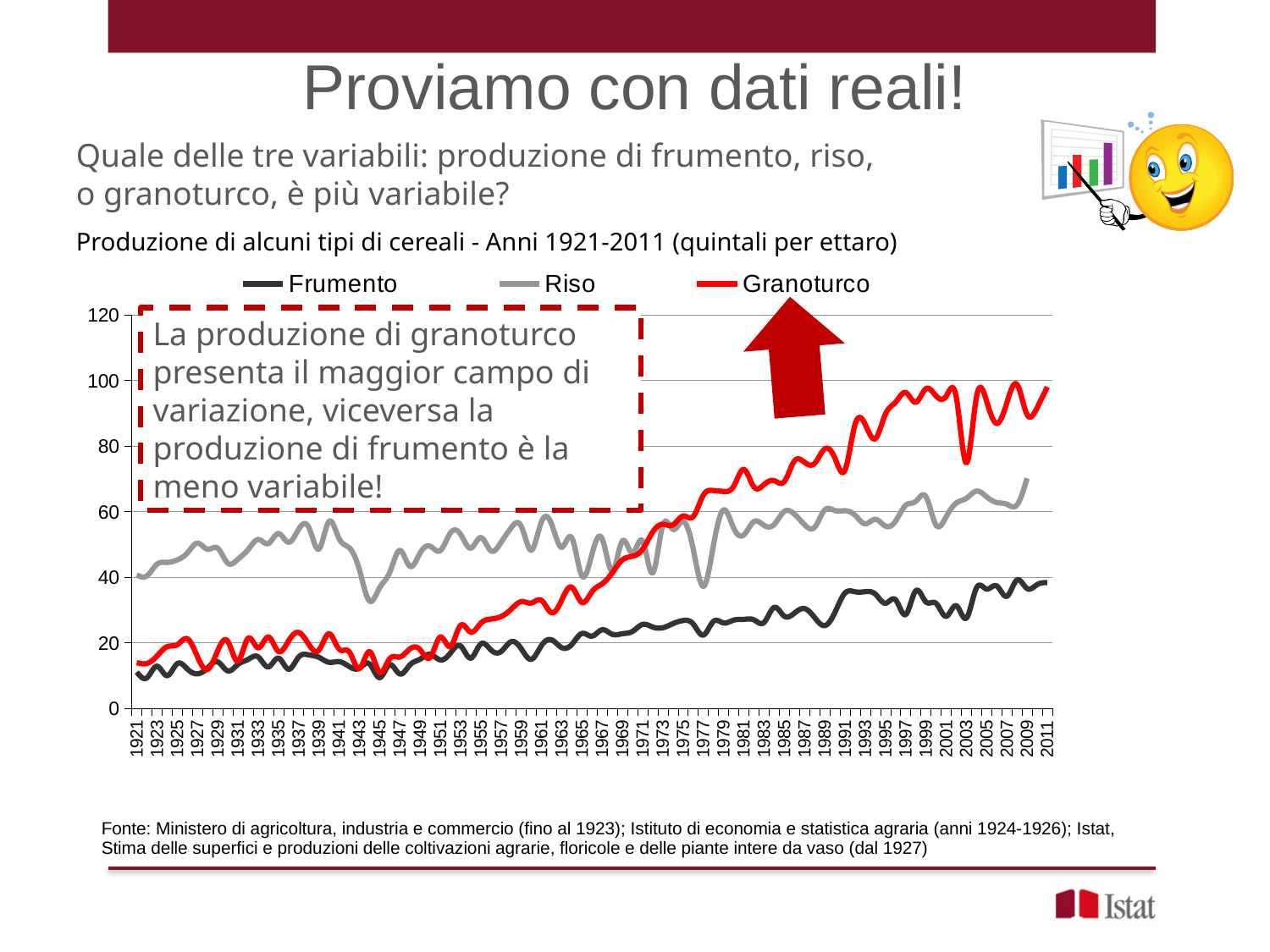
What is the title of the chart? Produzione di alcuni tipi di cereali - Anni 1921-2011 (quintali per ettaro) How many series does the chart's legend list? 3 Which series has the lowest value in 2011? Frumento In 1921, which is larger: the value for Riso or the value for Frumento? Riso Is the value for Granoturco in 2011 greater or less than 80? greater Is the value for Frumento in 2011 greater or less than 60? less Which series has the highest value in 1921? Riso Which series has the highest value in 2011? Granoturco What are the three series named in the chart's legend? Frumento, Riso, Granoturco What kind of chart is shown on the slide? line chart Does the Granoturco series generally rise or fall from 1921 to 2011? rise Is the value for Granoturco in 1921 greater or less than 20? less